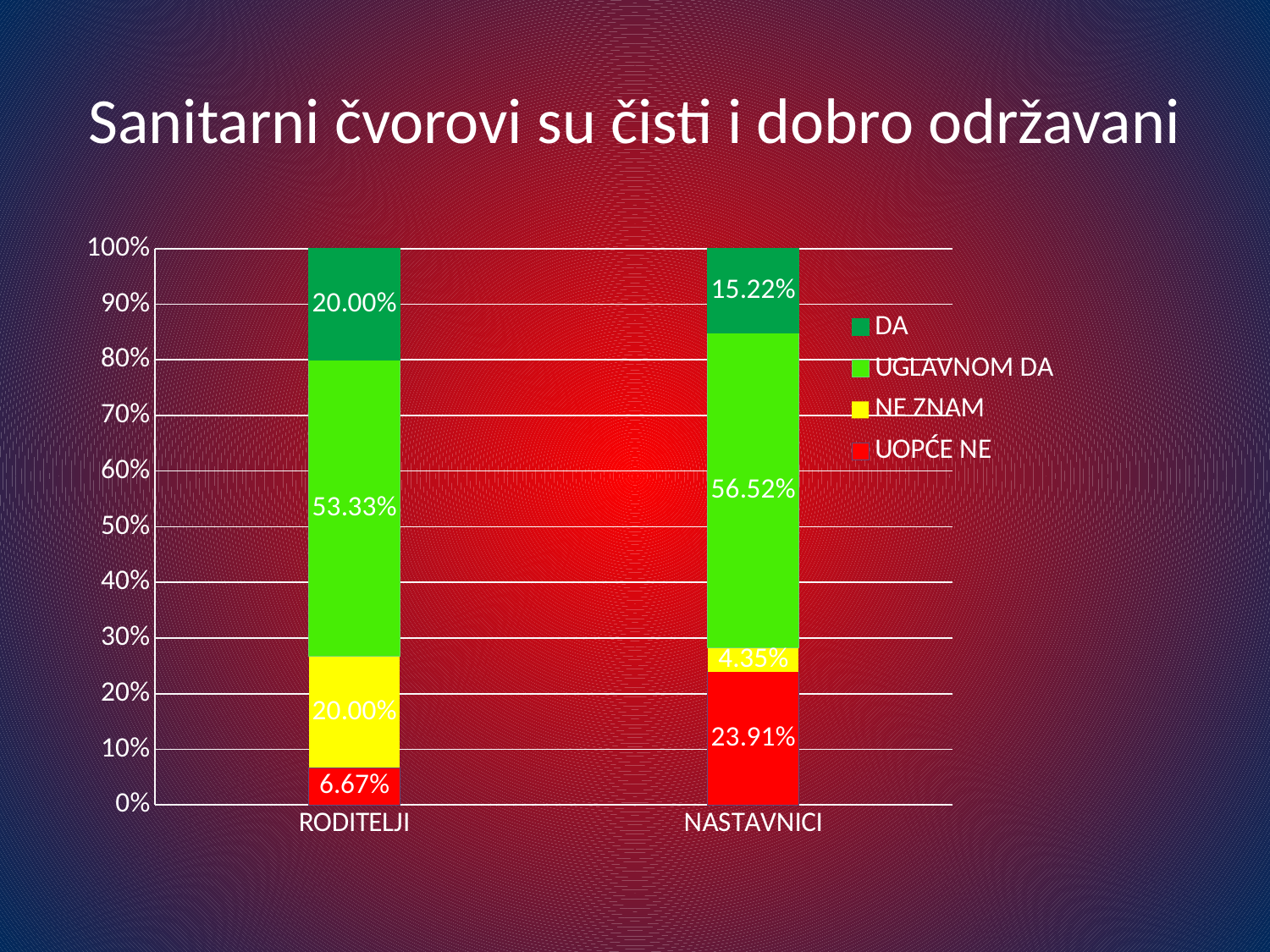
What is the value for UGLAVNOM DA for RODITELJI? 53.33% Which category has the higher value for UOPĆE NE, RODITELJI or NASTAVNICI? NASTAVNICI What is the value for DA for RODITELJI? 20.00% How many categories are shown on the x axis? 2 How many series does the legend list? 4 What is the value for UOPĆE NE for RODITELJI? 6.67% What is the difference between the UGLAVNOM DA values for NASTAVNICI and RODITELJI? 3.19% What is the value for UOPĆE NE for NASTAVNICI? 23.91% Which category has the higher value for DA, RODITELJI or NASTAVNICI? RODITELJI What is the difference between the NE ZNAM values for RODITELJI and NASTAVNICI? 15.65% What kind of chart is shown on the slide? Stacked bar chart What is the value for NE ZNAM for NASTAVNICI? 4.35%